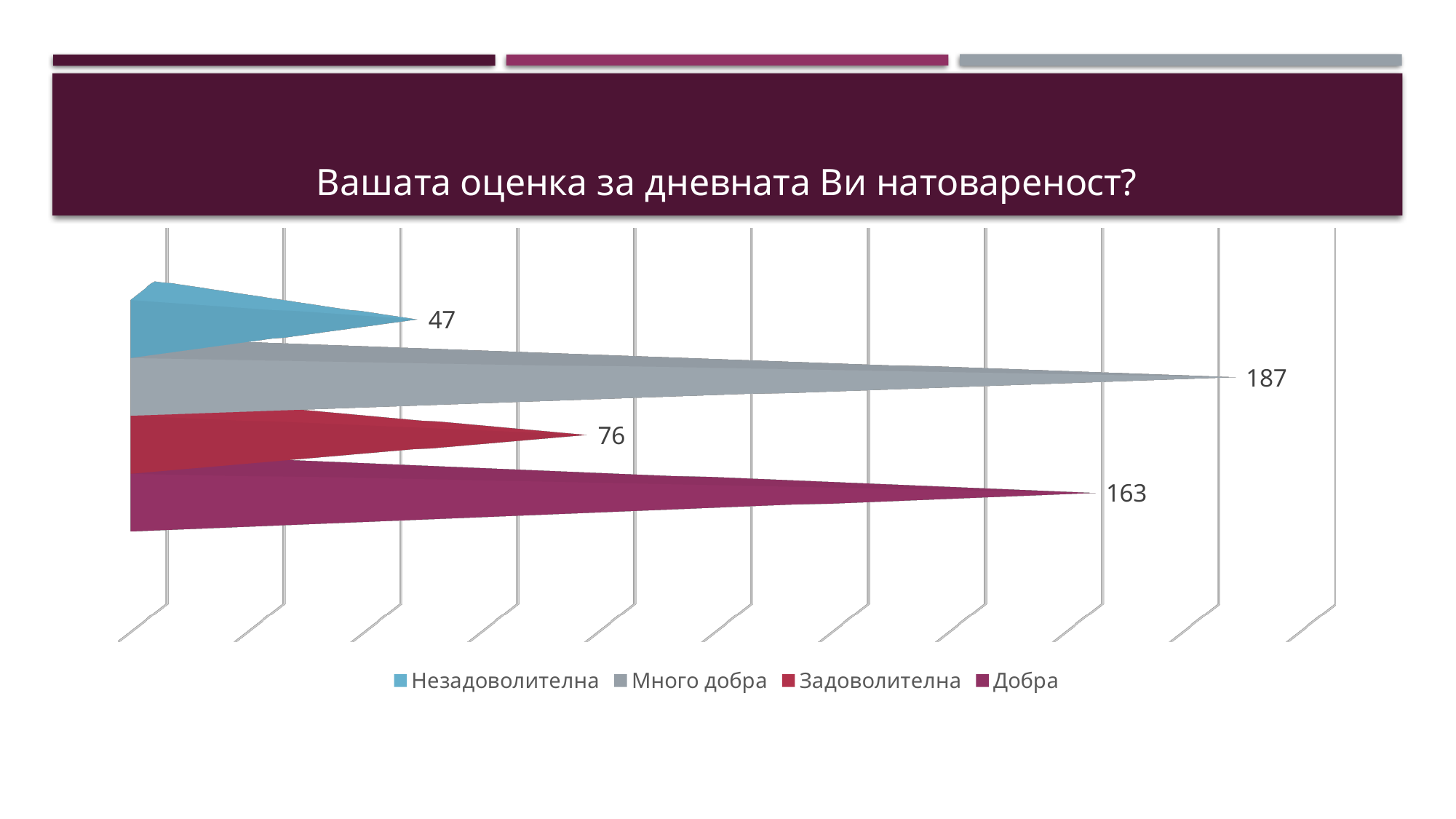
What is the title of the chart? Вашата оценка за дневната Ви натовареност? Which is larger, the value for Добра or the value for Задоволителна? Добра What is the difference between the values for Задоволителна and Незадоволителна? 29 What kind of chart is shown on the slide? Bar chart What is the value for Задоволителна? 76 How many series does the legend list? 4 What is the value for Незадоволителна? 47 What is the value for Много добра? 187 What is the difference between the values for Много добра and Добра? 24 Which category has the lowest value? Незадоволителна Which category has the highest value? Много добра What is the value for Добра? 163